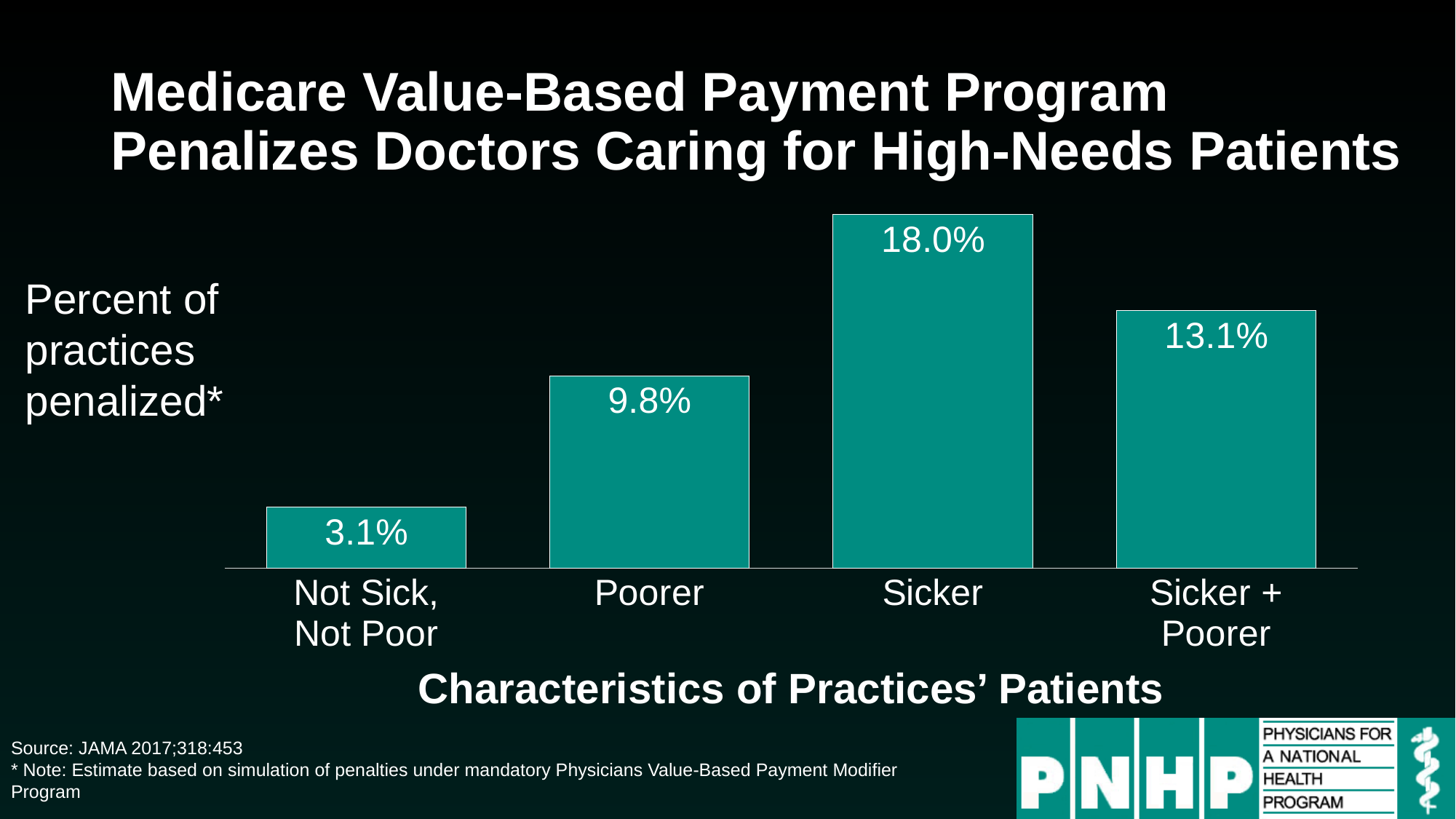
What percent of practices with Sicker + Poorer patients are penalized? 13.1% What percent of practices with Sicker patients are penalized? 18.0% What type of chart is shown on the slide? Bar chart What is the label of the x axis of the chart? Characteristics of Practices' Patients What is the difference in percent of practices penalized between the Sicker + Poorer and Poorer categories? 3.3% How many patient characteristic categories are shown in the chart? 4 What is the difference in percent of practices penalized between the Sicker and Not Sick, Not Poor categories? 14.9% Which patient characteristic category has the highest percent of practices penalized? Sicker Which patient characteristic category has the lowest percent of practices penalized? Not Sick, Not Poor What percent of practices with patients who are Not Sick, Not Poor are penalized? 3.1% What percent of practices with Poorer patients are penalized? 9.8% Which category has a larger percent of practices penalized, Sicker or Sicker + Poorer? Sicker